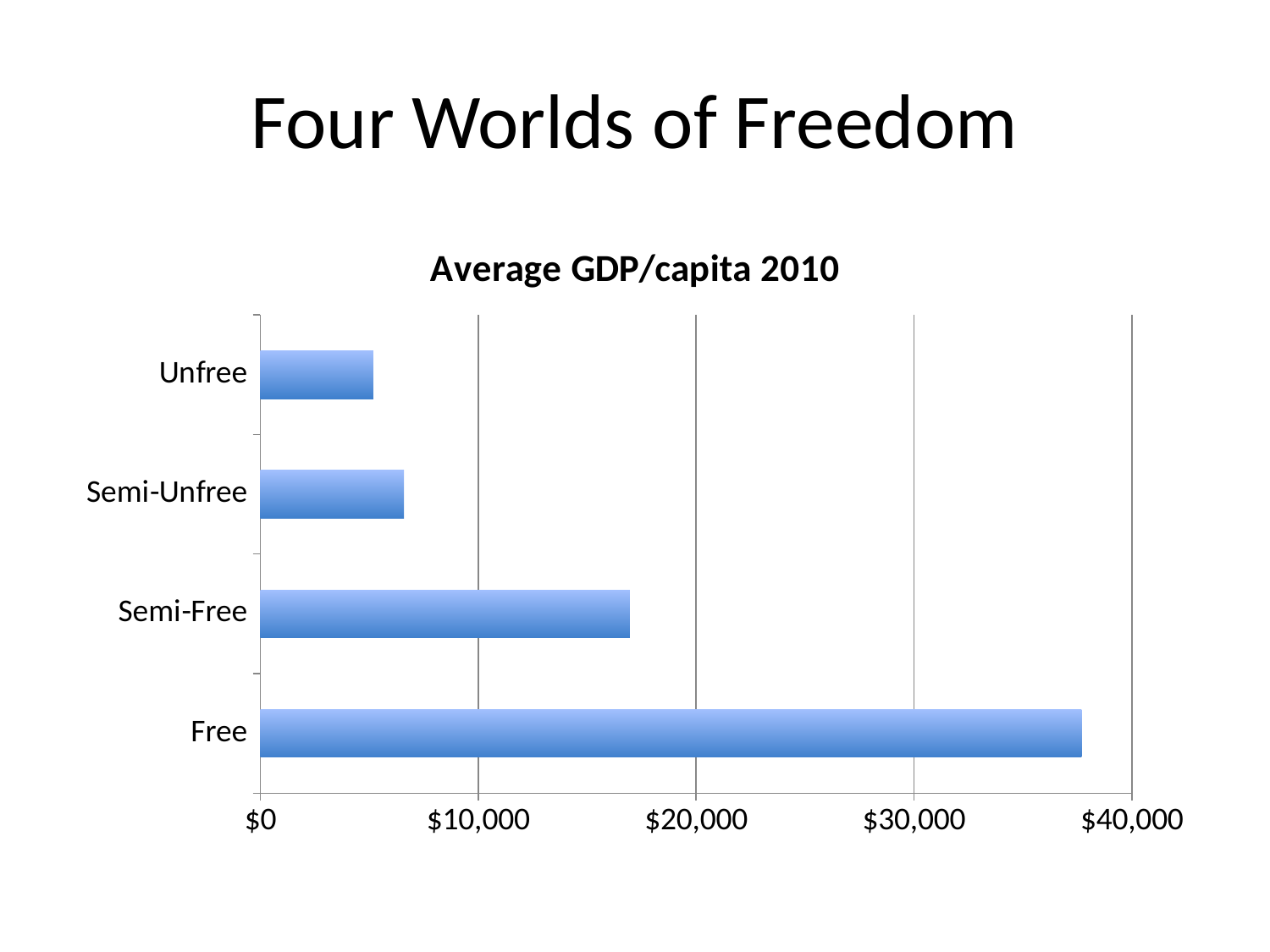
How many categories are plotted in the chart? 4 Which has a higher average GDP per capita, Unfree or Semi-Unfree? Semi-Unfree What is the highest value shown on the horizontal axis? $40,000 Which category has the lowest average GDP per capita? Unfree Which category has the highest average GDP per capita? Free What kind of chart is shown on the slide? bar chart Is the value for Semi-Free greater or less than $20,000? less Is the value for Semi-Free greater or less than $10,000? greater Which has a higher average GDP per capita, Semi-Free or Semi-Unfree? Semi-Free Is the value for Unfree greater or less than $10,000? less What is the title of the chart? Average GDP/capita 2010